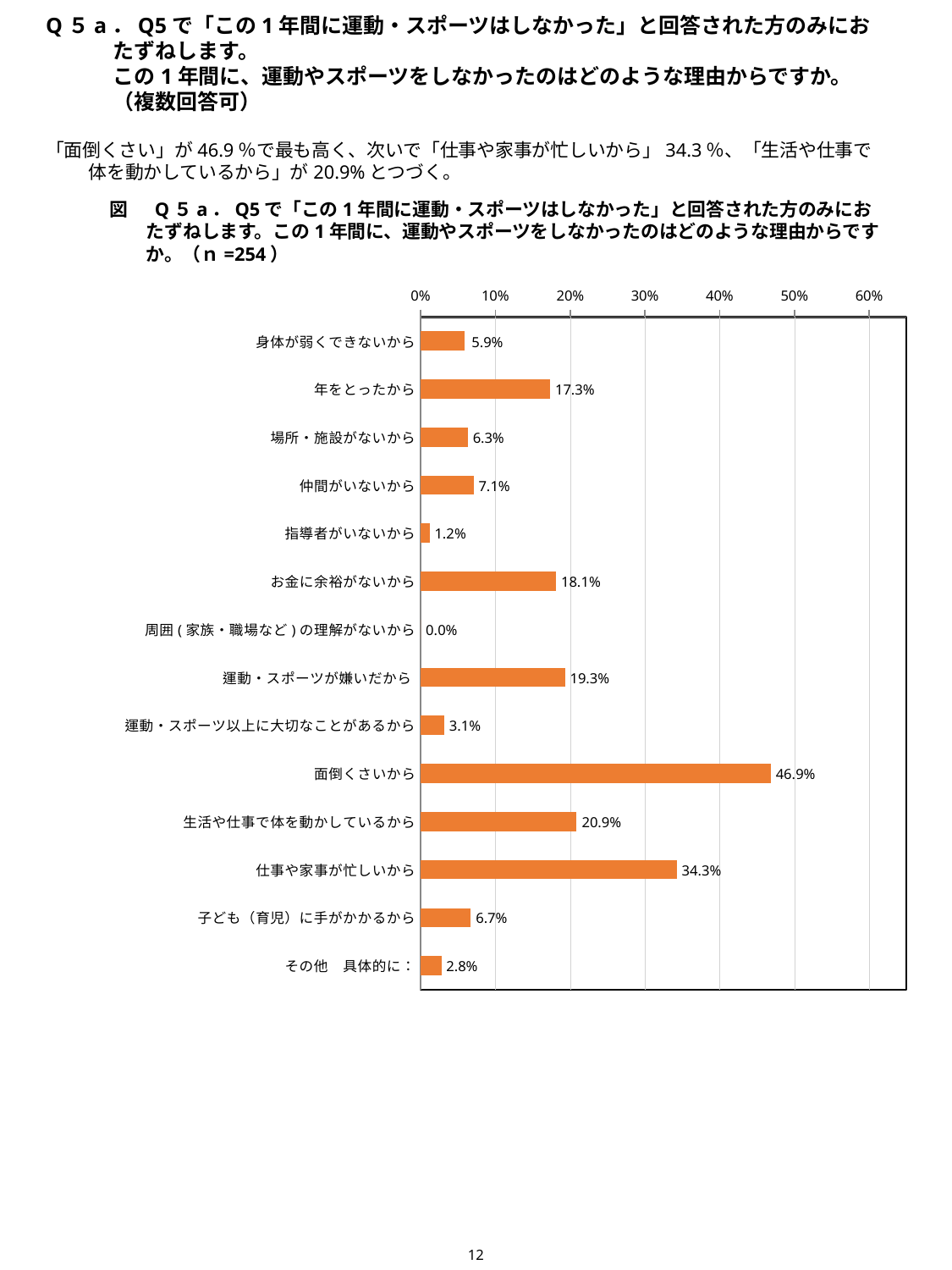
What is the value for 周囲(家族・職場など)の理解がないから? 0.0% What is the value for 仕事や家事が忙しいから? 34.3% What is the sample size (n) stated in the chart title? 254 What is the value for 面倒くさいから? 46.9% What is the difference between 面倒くさいから and 仕事や家事が忙しいから? 12.6% Which is larger, 年をとったから or お金に余裕がないから? お金に余裕がないから Is the value for 生活や仕事で体を動かしているから greater or less than 20%? greater Which category has the lowest value? 周囲(家族・職場など)の理解がないから What is the value for 指導者がいないから? 1.2% What kind of chart is this? bar chart Which category has the highest value? 面倒くさいから How many categories are shown in the chart? 14